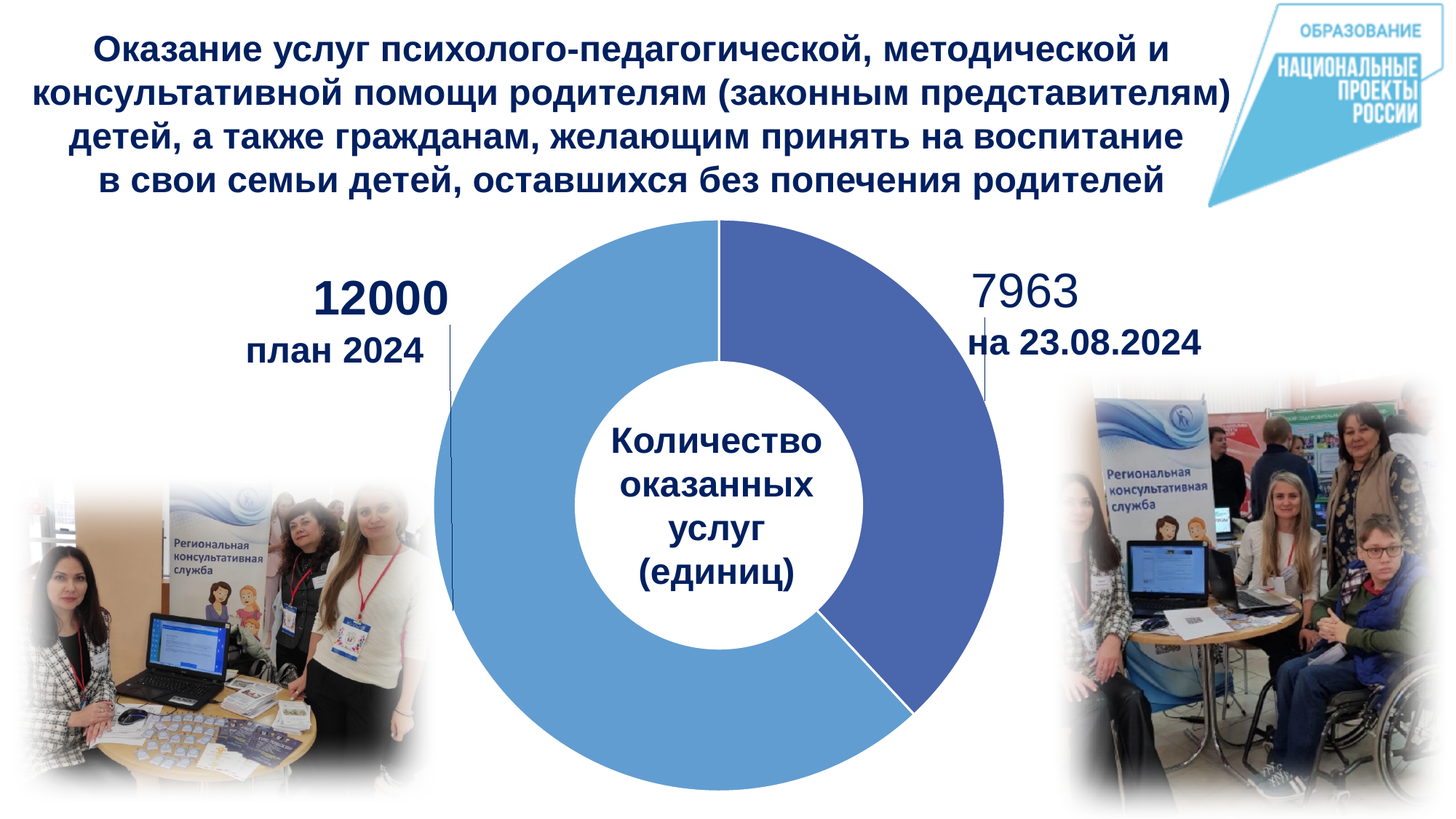
Which slice is drawn in the darker blue colour? на 23.08.2024 What text is written in the centre of the doughnut chart? Количество оказанных услуг (единиц) Which slice of the chart has the larger value? план 2024 Which slice of the chart has the smaller value? на 23.08.2024 What is the difference between the value for "план 2024" and the value for "на 23.08.2024"? 4037 How many slices does the chart have? 2 What kind of chart is shown on the slide? doughnut (pie) chart Is the value for "план 2024" larger or smaller than the value for "на 23.08.2024"? larger What value is shown for "план 2024" on the chart? 12000 What value is shown for "на 23.08.2024" on the chart? 7963